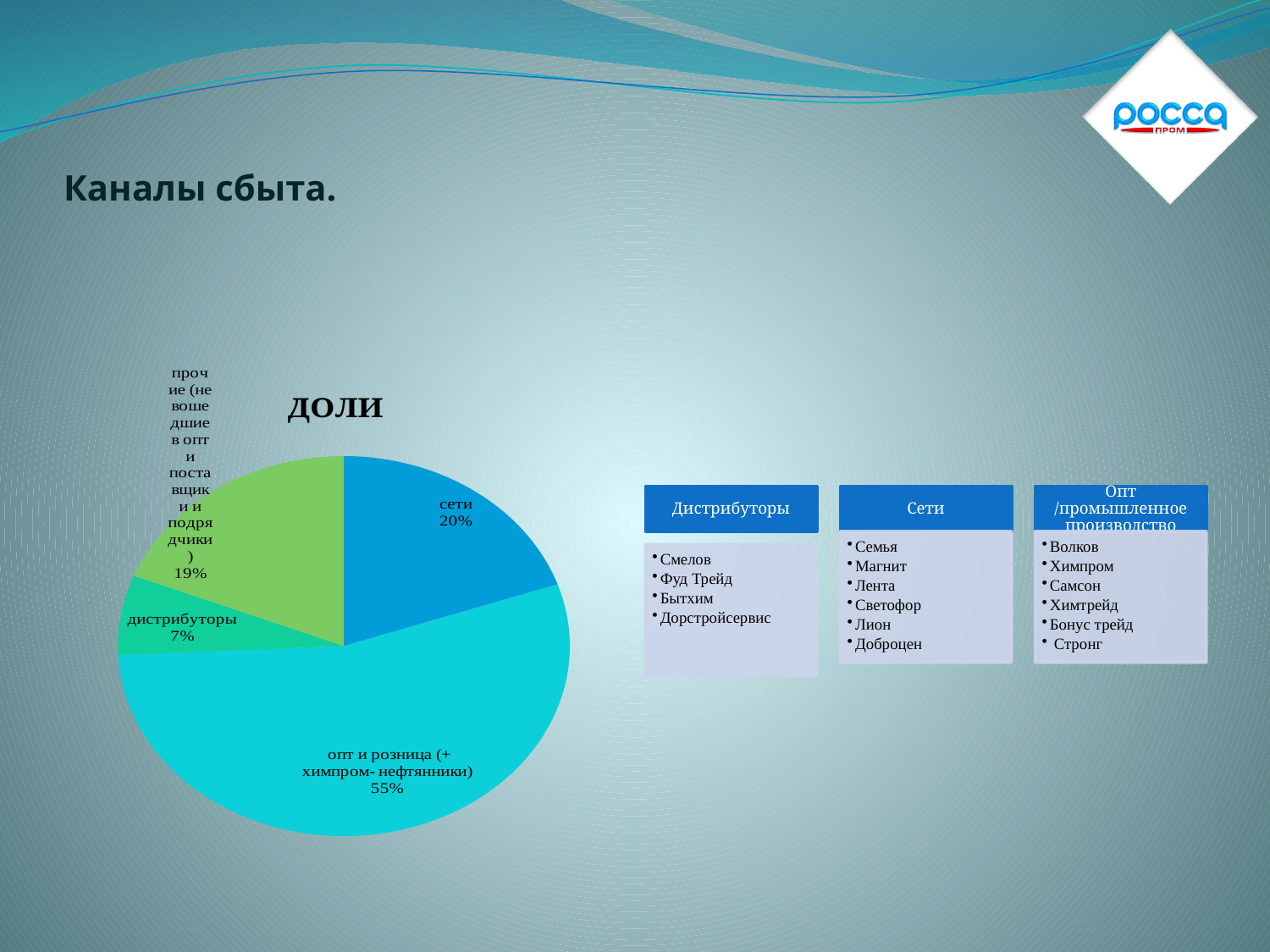
What is the difference in percentage points between "сети" and "прочие (не вошедшие в опт и поставщики и подрядчики)"? 1 Which slice of the pie chart is the smallest? дистрибуторы What is the difference in percentage points between "опт и розница (+ химпром- нефтянники)" and "сети"? 35 What share of the pie does "сети" have? 20% How many slices does the pie chart have? 4 What share of the pie does "прочие (не вошедшие в опт и поставщики и подрядчики)" have? 19% Which slice of the pie chart is the largest? опт и розница (+ химпром- нефтянники) What kind of chart is shown on the slide? pie chart What share of the pie does "дистрибуторы" have? 7% What share of the pie does "опт и розница (+ химпром- нефтянники)" have? 55% What is the title of the pie chart? ДОЛИ Which is larger, the share for "сети" or the share for "дистрибуторы"? сети